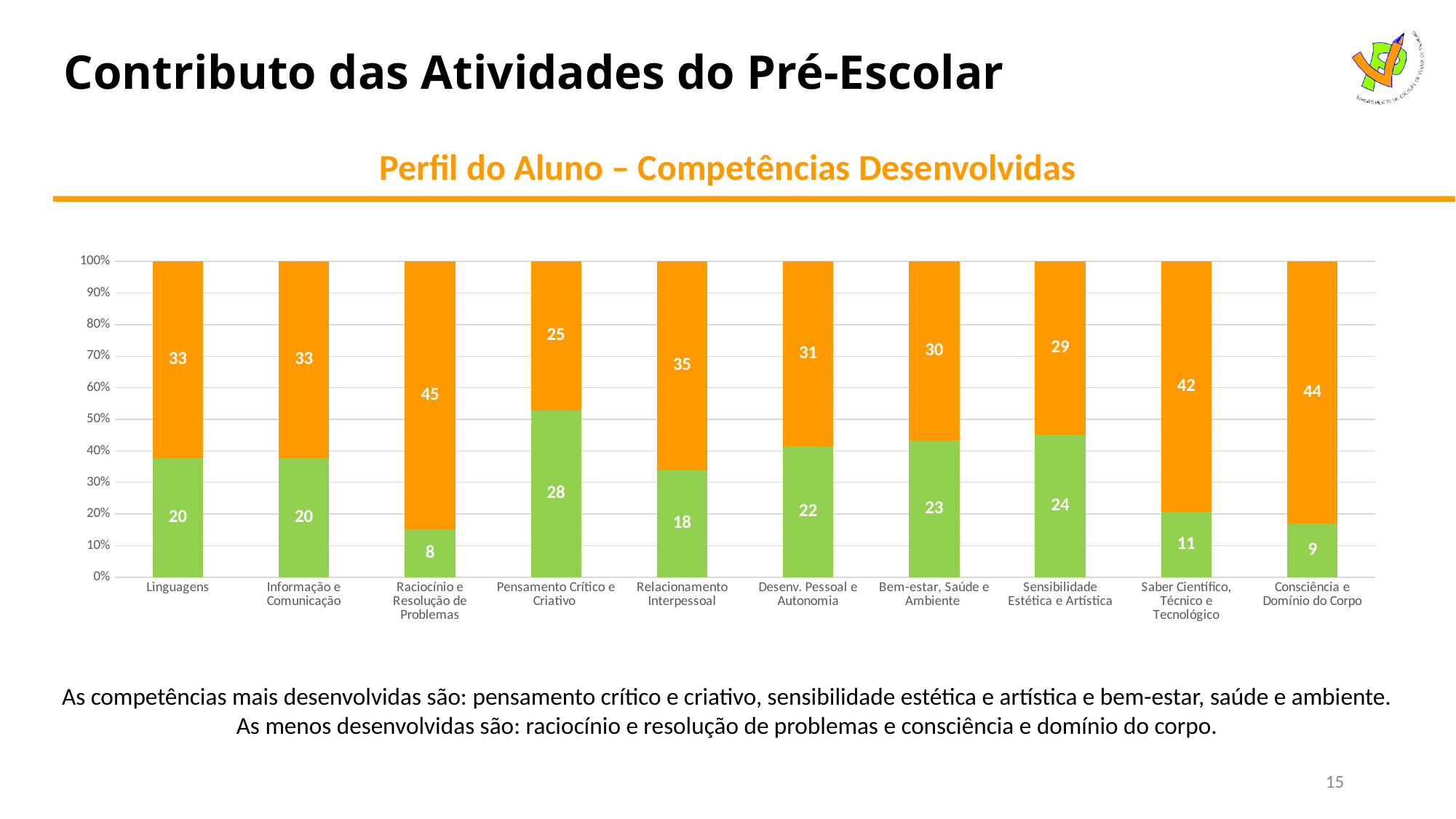
What is the value of the green segment for Relacionamento Interpessoal? 18 Which category has the highest orange segment value? Raciocínio e Resolução de Problemas Is the green segment for Saber Científico, Técnico e Tecnológico greater or less than 30% on the axis? less For Consciência e Domínio do Corpo, what is the difference between the orange value and the green value? 35 How many categories are shown on the x axis of the chart? 10 What kind of chart is shown on the slide? Stacked bar chart What is the value of the orange segment for Raciocínio e Resolução de Problemas? 45 What is the total of the green and orange values for the Linguagens bar? 53 What is the value of the green segment for Linguagens? 20 Which category has the highest green segment value? Pensamento Crítico e Criativo Which has the larger green segment value: Bem-estar, Saúde e Ambiente or Sensibilidade Estética e Artística? Sensibilidade Estética e Artística Which category has the lowest green segment value? Raciocínio e Resolução de Problemas